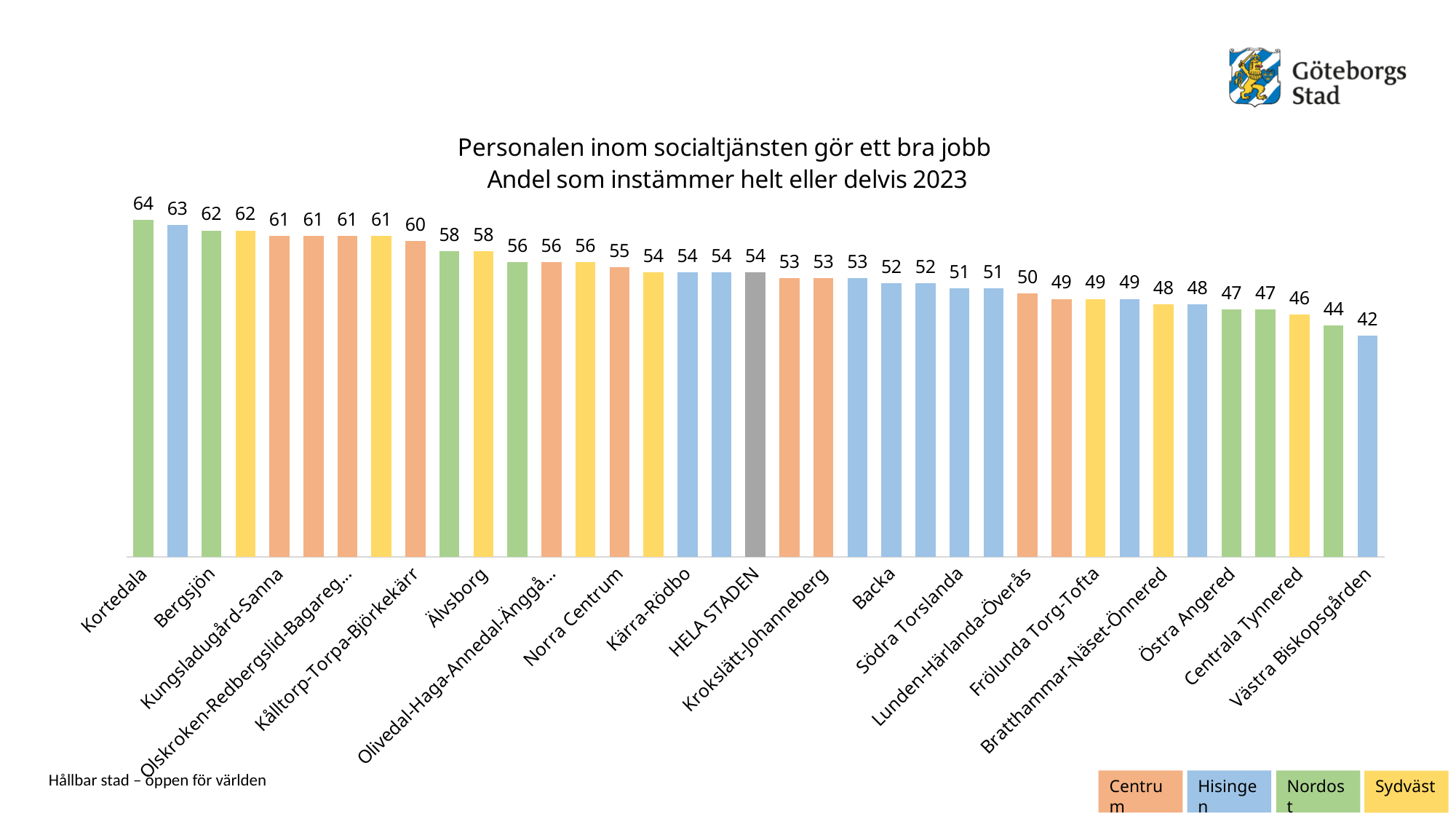
What is the value for Västra Biskopsgården? 42 What type of chart is shown on the slide? bar chart What is the value for Backa? 52 How many groups does the legend list? 4 What is the value for Älvsborg? 58 What is the value for Kortedala? 64 Which area has the highest value in the chart? Kortedala Which area has the lowest value in the chart? Västra Biskopsgården What is the value for HELA STADEN? 54 Do the values rise or fall from left to right along the x axis? fall What is the difference between the values for Kortedala and Västra Biskopsgården? 22 Which has a higher value, Bergsjön or Frölunda Torg-Tofta? Bergsjön